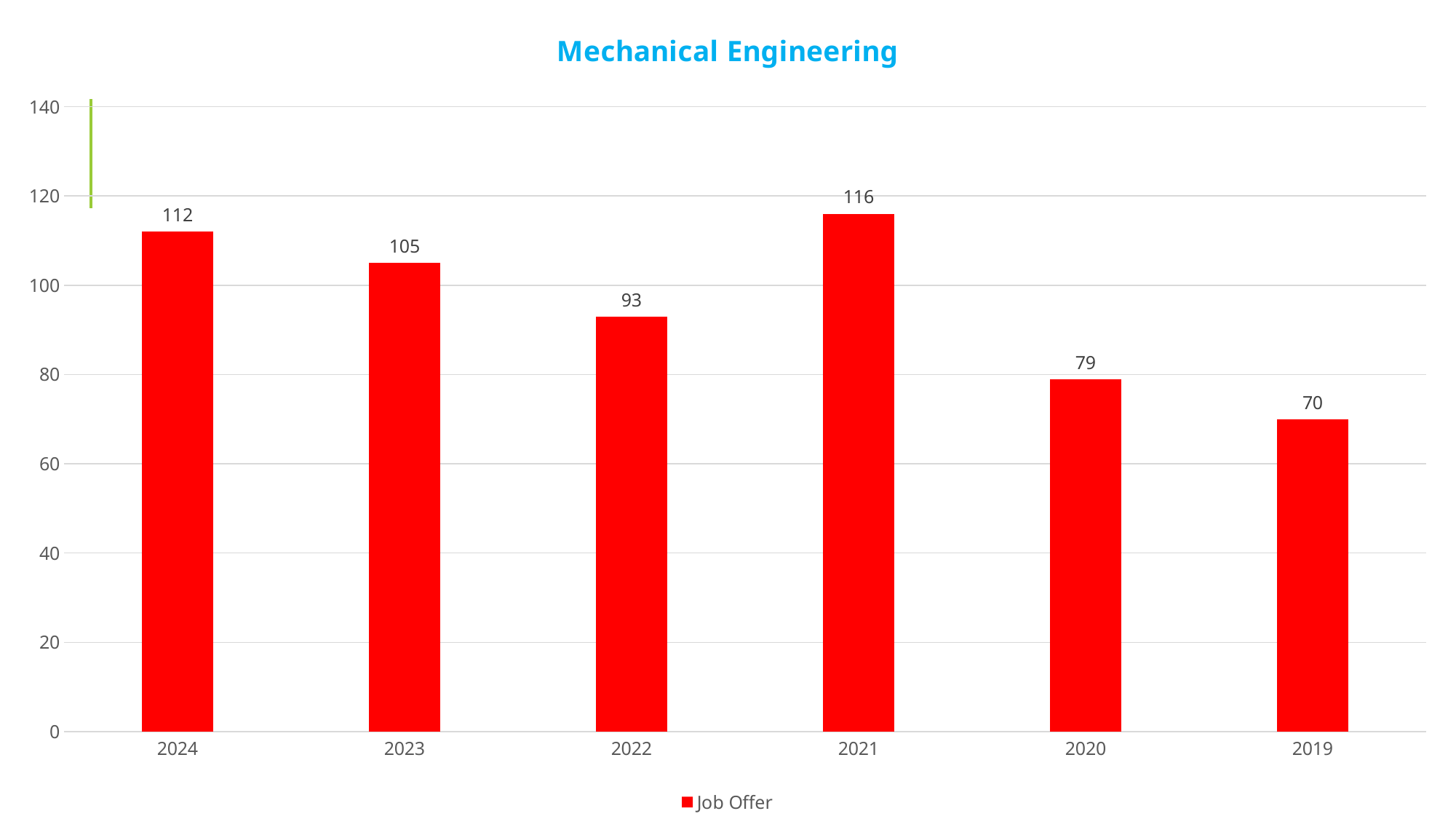
What is the Job Offer value for 2024? 112 Which year has the highest Job Offer value? 2021 What is the difference between the Job Offer values for 2021 and 2020? 37 What is the difference between the Job Offer values for 2024 and 2023? 7 What is the Job Offer value for 2022? 93 Which is larger, the Job Offer value for 2023 or for 2022? 2023 What is the title of the chart? Mechanical Engineering Which year has the lowest Job Offer value? 2019 What is the Job Offer value for 2019? 70 How many years are shown on the x axis? 6 Is the Job Offer value for 2020 greater or less than 80? less What kind of chart is shown on the slide? bar chart